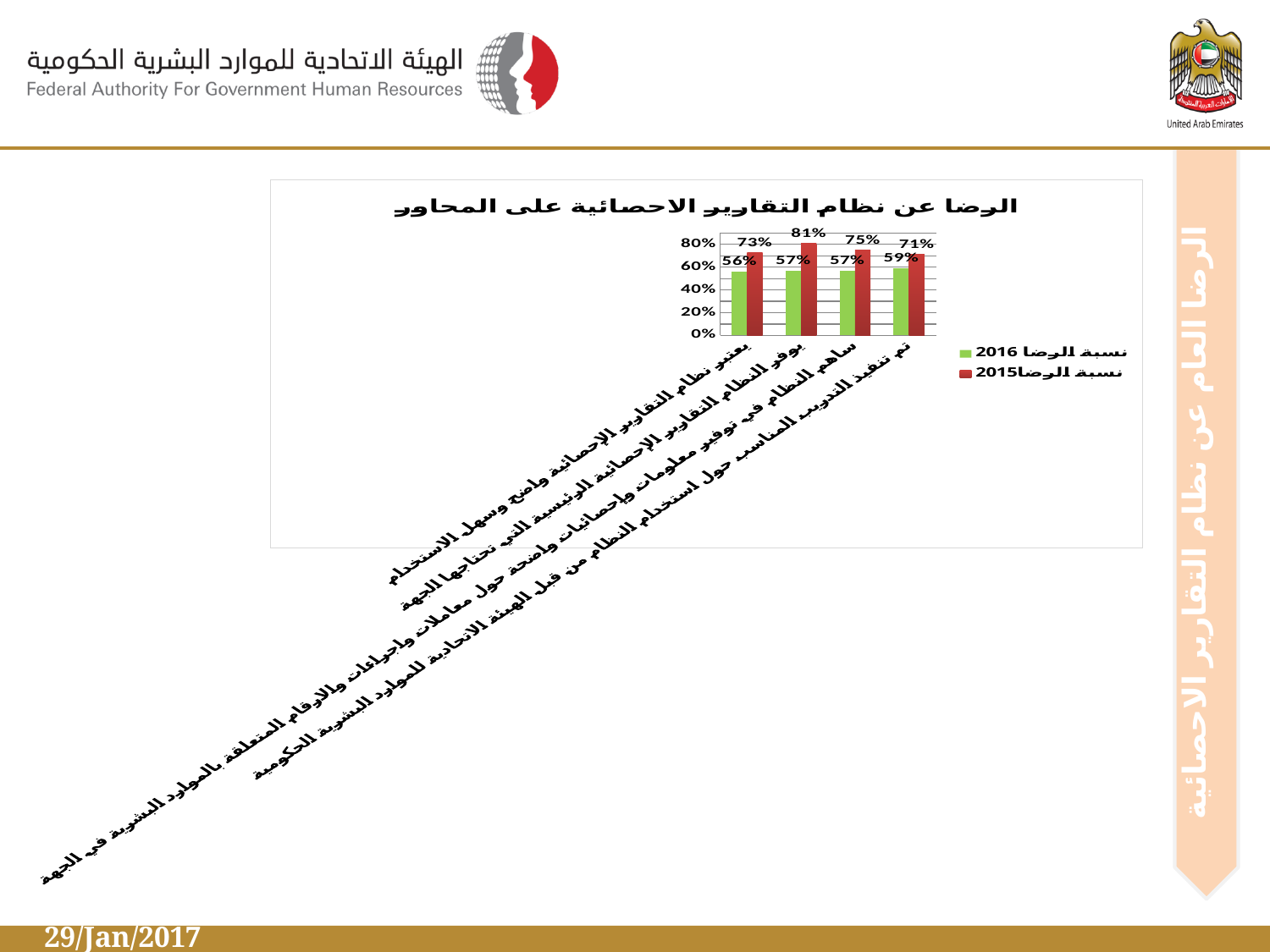
What type of chart is shown on the slide? Bar chart For the third category, 'ساهم النظام في توفير معلومات واحصائيات واضحة', which is larger: the 2015 rate or the 2016 rate? 2015 rate (75%) Which category has the lowest 2015 satisfaction rate (نسبة الرضا 2015)? تم تنفيذ التدريب المناسب حول استخدام النظام من قبل الهيئة الاتحادية للموارد البشرية الحكومية How many categories are plotted along the x axis of the chart? 4 Which category has the highest 2015 satisfaction rate (نسبة الرضا 2015)? يوفر النظام التقارير الإحصائية الرئيسية التي تحتاجها الجهة What is the 2016 satisfaction rate (نسبة الرضا 2016) for the first category, 'يعتبر نظام التقارير الإحصائية واضح وسهل الاستخدام'? 56% Which colour represents the series 'نسبة الرضا 2016' in the chart? Green What is the difference between the 2015 and 2016 satisfaction rates for the second category, 'يوفر النظام التقارير الإحصائية الرئيسية التي تحتاجها الجهة'? 24% How many series does the legend of the chart list? 2 What is the 2015 satisfaction rate (نسبة الرضا 2015) for the second category, 'يوفر النظام التقارير الإحصائية الرئيسية التي تحتاجها الجهة'? 81% What is the 2016 satisfaction rate (نسبة الرضا 2016) for the fourth category, 'تم تنفيذ التدريب المناسب حول استخدام النظام'? 59% Is the 2015 satisfaction rate for the first category, 'يعتبر نظام التقارير الإحصائية واضح وسهل الاستخدام', greater or less than 60%? greater